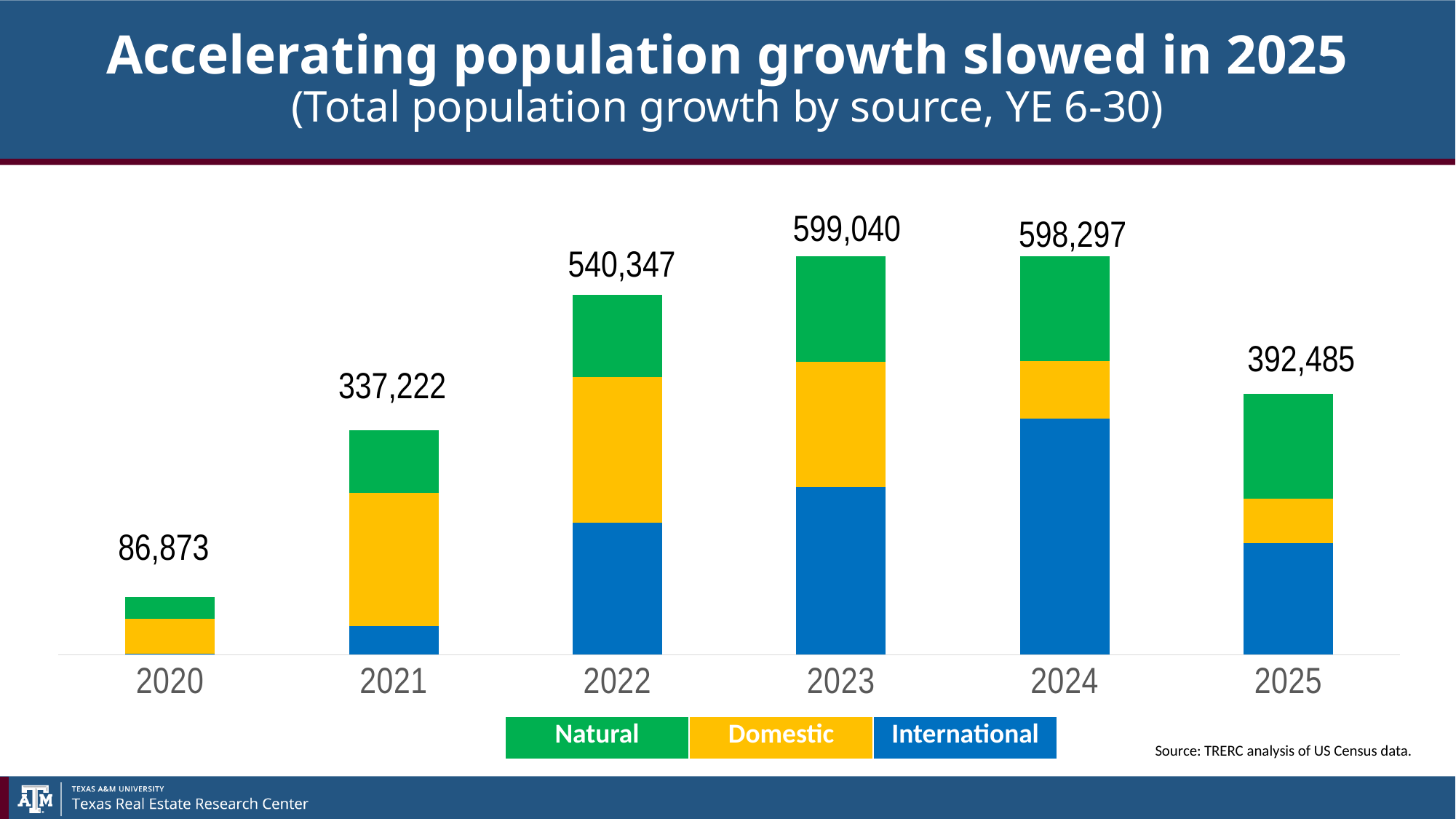
Which year has a larger total population growth, 2022 or 2025? 2022 How many series does the legend list? 3 What is the total population growth shown for 2025? 392,485 What is the total population growth shown for 2020? 86,873 What is the difference between the total for 2023 and the total for 2025? 206,555 Which year has the lowest total population growth? 2020 What is the total population growth shown for 2022? 540,347 What kind of chart is shown on the slide? Stacked bar chart How many years are shown on the x axis? 6 In 2024, which segment is larger, International or Domestic? International Which year has the highest total population growth? 2023 What is the difference between the total for 2021 and the total for 2020? 250,349